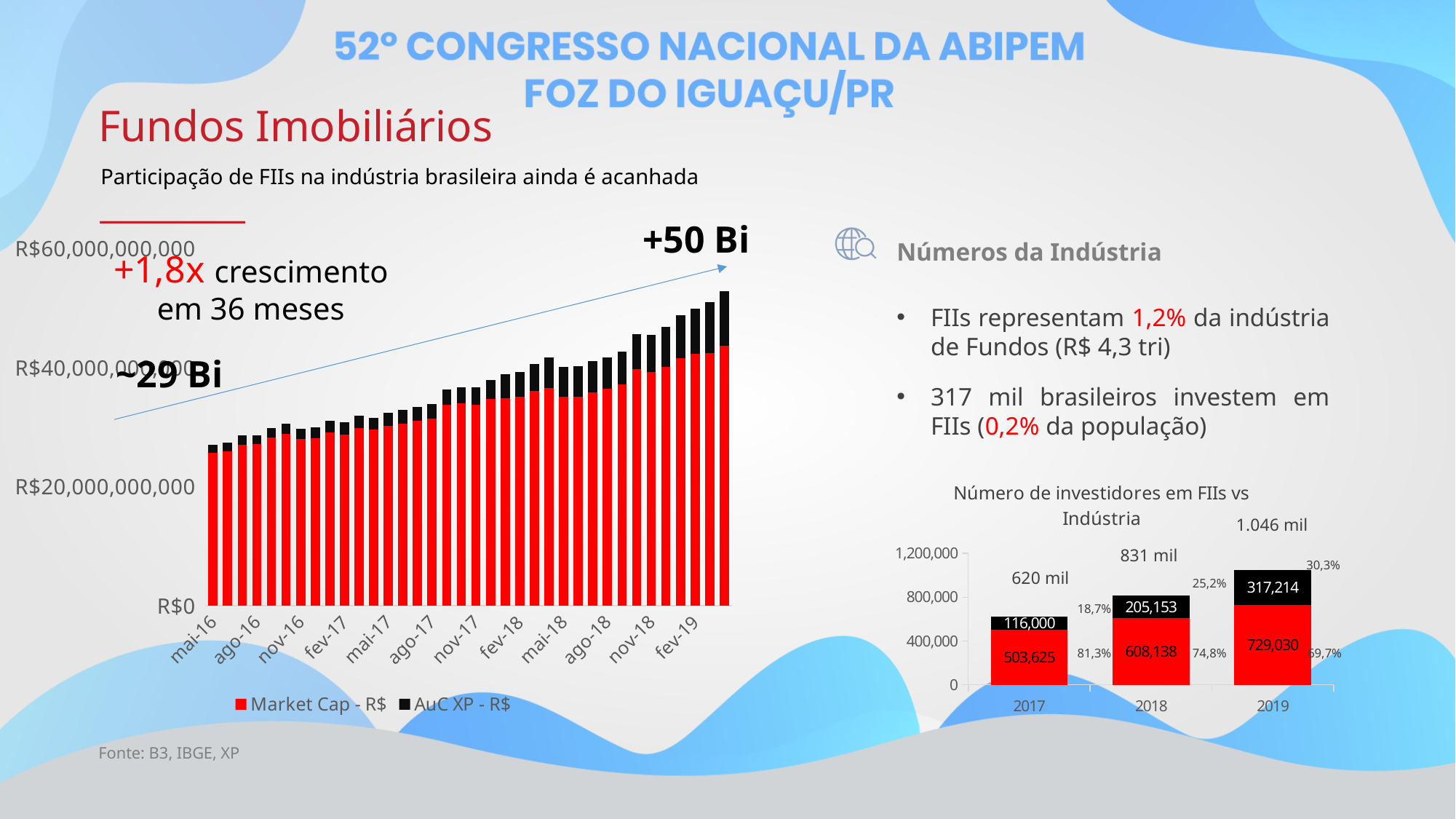
In the chart titled 'Número de investidores em FIIs vs Indústria', what total label is shown above the 2019 bar? 1.046 mil What kind of chart is the left chart with the 'Market Cap - R$' legend? stacked bar chart In the chart titled 'Número de investidores em FIIs vs Indústria', what is the value of the black segment for 2017? 116,000 In the chart titled 'Número de investidores em FIIs vs Indústria', what is the value of the red segment for 2018? 608,138 In the chart titled 'Número de investidores em FIIs vs Indústria', is the black segment for 2018 larger or smaller than the black segment for 2019? smaller In the chart titled 'Número de investidores em FIIs vs Indústria', which year has the largest black segment? 2019 In the chart titled 'Número de investidores em FIIs vs Indústria', what is the difference between the red segment values for 2019 and 2017? 225,405 In the left chart with the 'Market Cap - R$' legend, how many series does the legend list? 2 In the chart titled 'Número de investidores em FIIs vs Indústria', how many years are shown on the x axis? 3 In the left chart with the 'Market Cap - R$' legend, is the total stacked value for fev-19 greater or less than R$40,000,000,000? greater In the chart titled 'Número de investidores em FIIs vs Indústria', what is the value of the red segment for 2019? 729,030 In the left chart with the 'Market Cap - R$' legend, do the stacked bar totals generally rise or fall from mai-16 to fev-19? rise